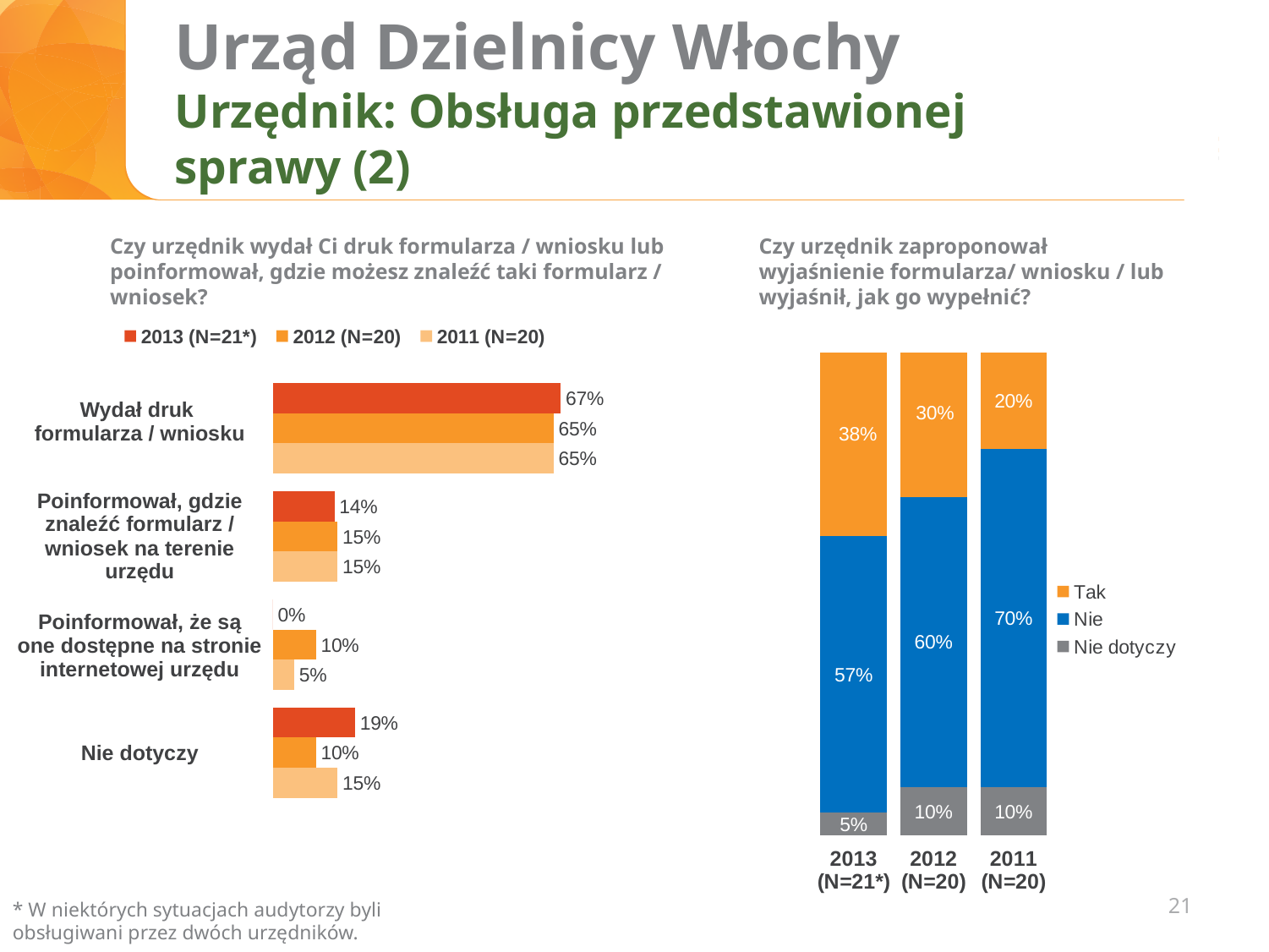
In the left chart, which category has the lowest 2013 (N=21*) value? Poinformował, że są one dostępne na stronie internetowej urzędu In the left chart, what is the 2012 (N=20) value for "Poinformował, że są one dostępne na stronie internetowej urzędu"? 10% In the left chart, how many series does the legend list? 3 In the right chart, what is the "Nie" value for 2012 (N=20)? 60% In the right chart, what is the "Tak" value for 2013 (N=21*)? 38% In the left chart, which category has the highest 2013 (N=21*) value? Wydał druk formularza / wniosku What kind of chart is the right chart? Stacked bar chart In the left chart, what is the difference between the 2013 and 2012 values for "Nie dotyczy"? 9% In the left chart, what is the 2013 (N=21*) value for "Wydał druk formularza / wniosku"? 67% In the left chart, what is the 2011 (N=20) value for "Nie dotyczy"? 15% In the right chart, which year has the larger "Nie" value, 2013 (N=21*) or 2011 (N=20)? 2011 (N=20) In the left chart, how many categories are shown? 4